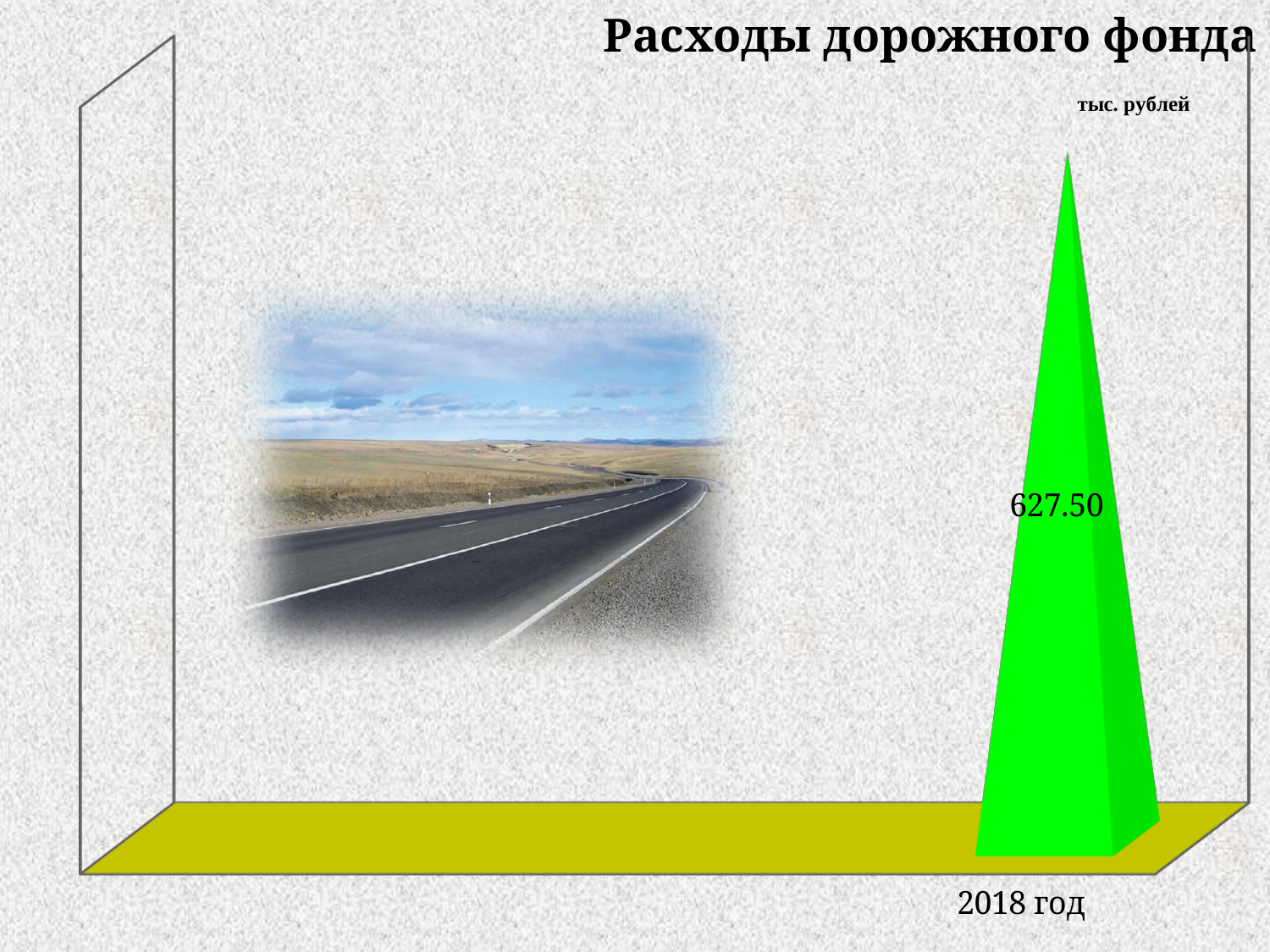
How many categories are plotted on the chart? 1 What is the title of the chart? Расходы дорожного фонда Which year is shown on the x axis of the chart? 2018 год What is the value shown for 2018 год? 627.50 What kind of chart is shown on the slide? bar chart In what units are the chart values given? тыс. рублей